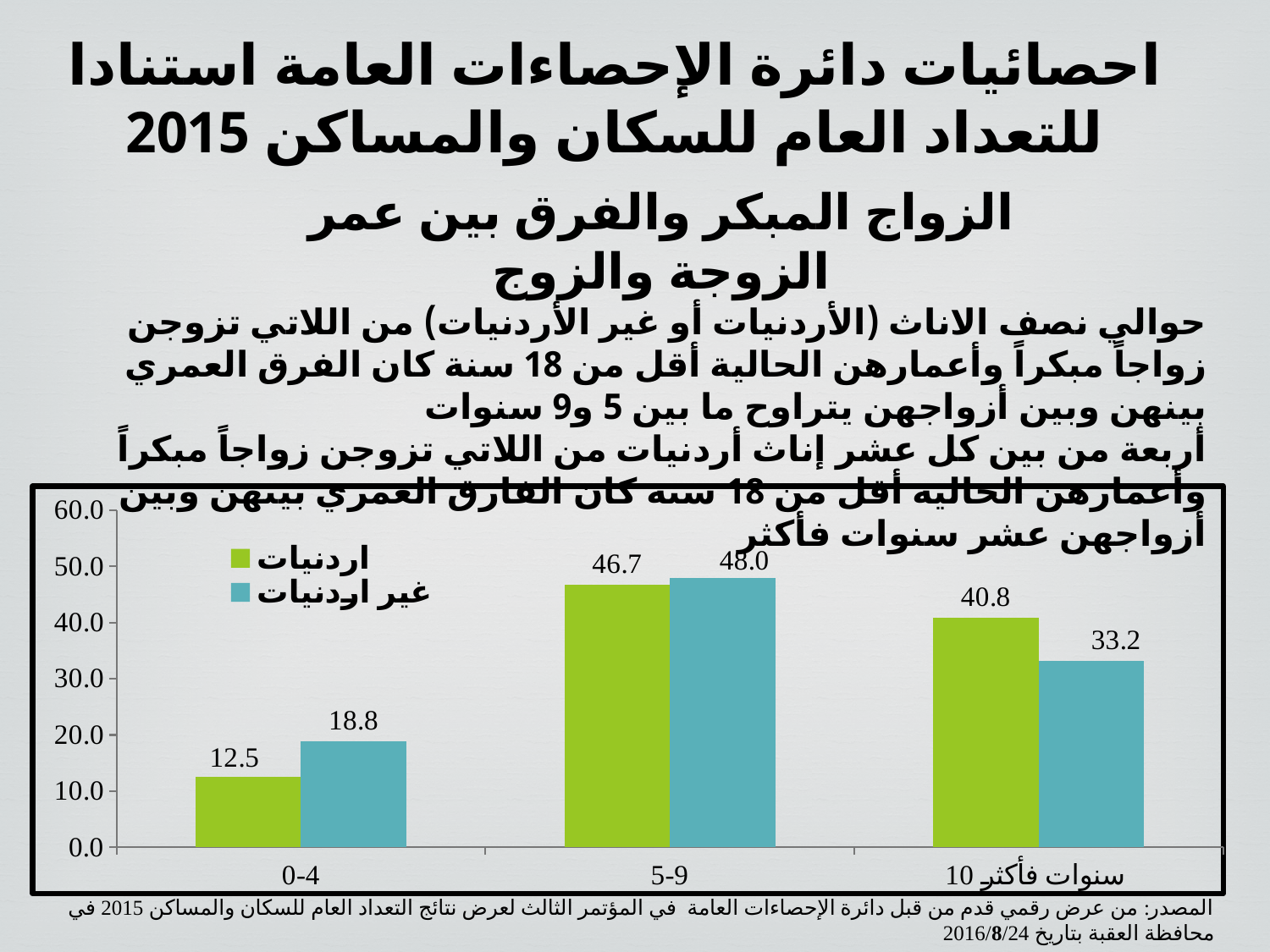
Which series is shown in green in the chart? اردنيات Which category has the lowest value for غير اردنيات? 0-4 Which category has the highest value for اردنيات? 5-9 What is the value for اردنيات in the 10 سنوات فأكثر category? 40.8 In the 0-4 category, which series has the larger value, اردنيات or غير اردنيات? غير اردنيات What is the value for غير اردنيات in the 5-9 category? 48.0 How many series does the chart legend list? 2 What is the value for غير اردنيات in the 10 سنوات فأكثر category? 33.2 How many categories are shown on the x axis of the chart? 3 What is the value for اردنيات in the 0-4 category? 12.5 What type of chart is shown on the slide? bar chart What is the difference between the اردنيات and غير اردنيات values in the 10 سنوات فأكثر category? 7.6